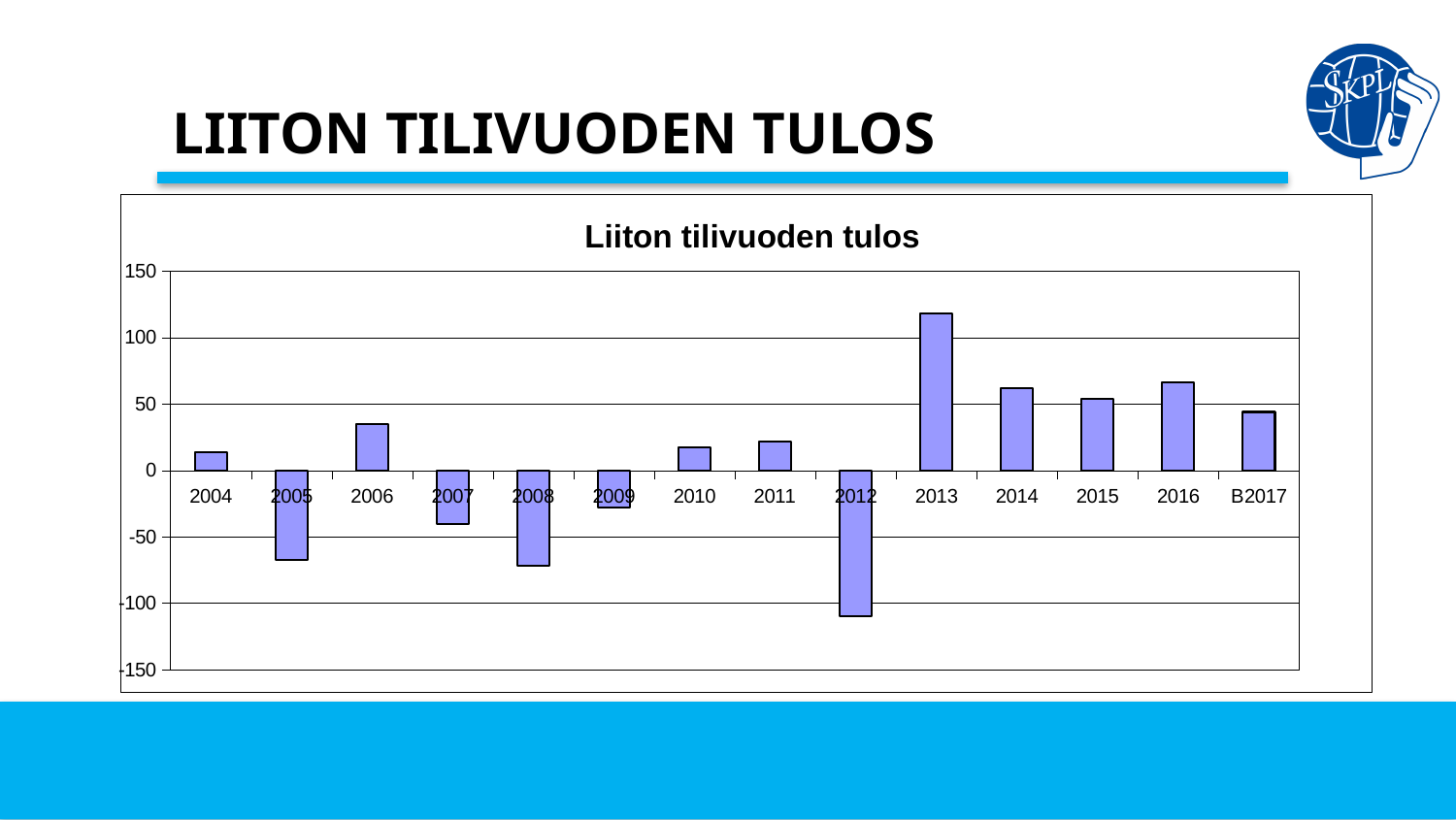
Is the value for 2014 greater or less than 50? greater Is the value for 2013 greater or less than 100? greater Which year has the highest value in the chart? 2013 What is the title of the chart? Liiton tilivuoden tulos Which is larger, the value for 2013 or the value for 2014? 2013 What kind of chart is shown on the slide? bar chart Is the value for 2006 greater or less than 50? less Which year has the lowest value in the chart? 2012 Which is larger, the value for 2006 or the value for 2004? 2006 How many categories are shown on the x axis of the chart? 14